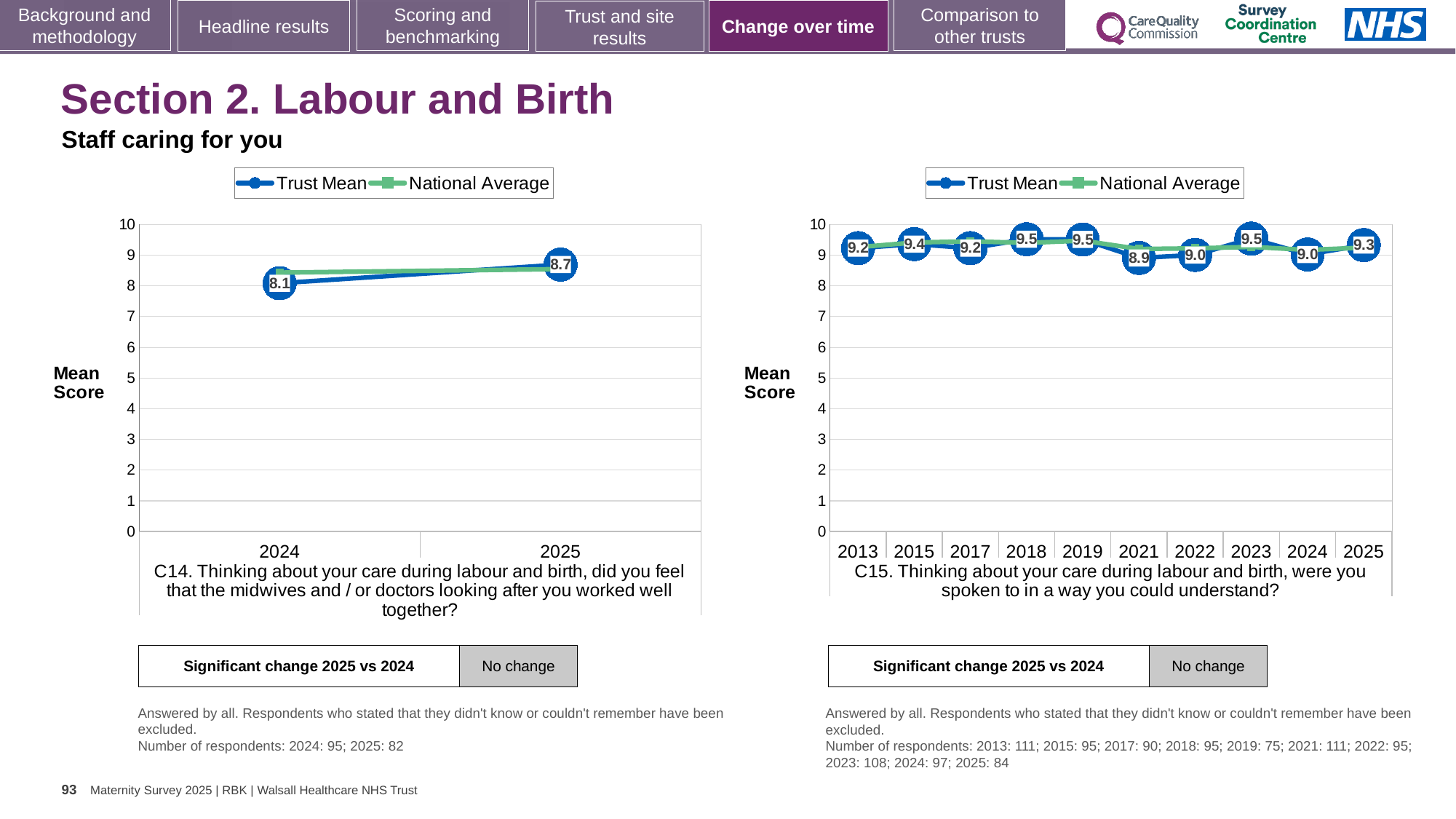
In the C15 chart on the right, which is larger, the Trust Mean for 2018 or for 2021? 2018 How many years are plotted on the x axis of the C15 chart on the right? 10 In the C14 chart on the left, by how much did the Trust Mean change from 2024 to 2025? 0.6 In the C15 chart on the right, what is the difference between the Trust Mean for 2023 and for 2024? 0.5 What kind of chart is the C15 chart on the right? line chart In the C14 chart on the left, what is the Trust Mean for 2024? 8.1 In the C15 chart on the right, what is the Trust Mean for 2021? 8.9 In the C15 chart on the right, which year has the lowest Trust Mean? 2021 How many series does the legend of the C14 chart on the left list? 2 In the C14 chart on the left, does the Trust Mean rise or fall from 2024 to 2025? rise In the C14 chart on the left, what is the Trust Mean for 2025? 8.7 In the C15 chart on the right, what is the Trust Mean for 2025? 9.3